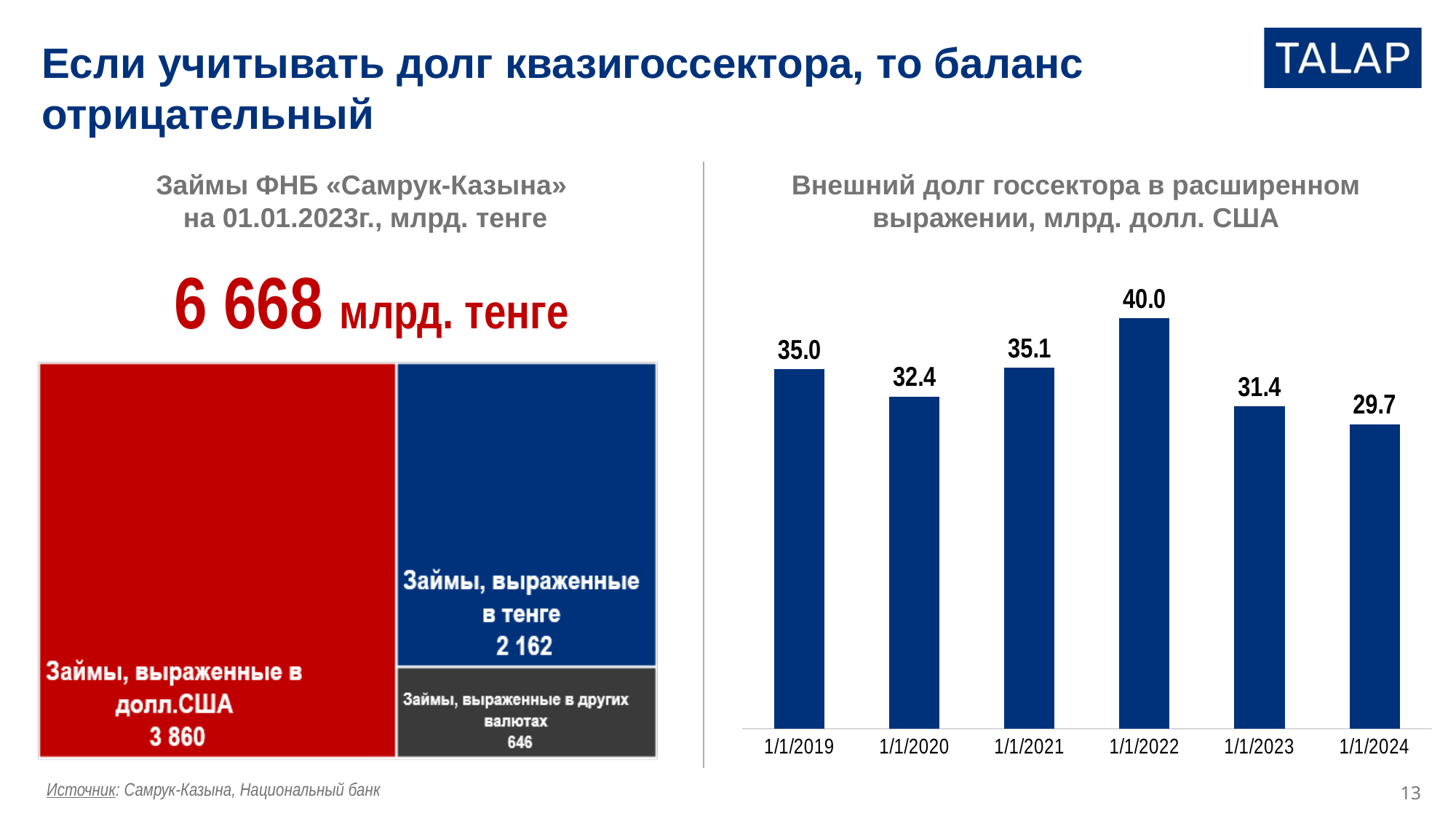
In the left chart (Займы ФНБ «Самрук-Казына»), what is the value for Займы, выраженные в долл.США? 3 860 In the right chart (Внешний долг госсектора в расширенном выражении), which is larger: the value for 1/1/2019 or for 1/1/2020? 1/1/2019 In the right chart (Внешний долг госсектора в расширенном выражении), what is the value for 1/1/2022? 40.0 In the right chart (Внешний долг госсектора в расширенном выражении), what is the difference between the values for 1/1/2022 and 1/1/2024? 10.3 What kind of chart is the right chart (Внешний долг госсектора в расширенном выражении)? bar chart In the left chart (Займы ФНБ «Самрук-Казына»), what is the difference between loans in US dollars and loans in tenge? 1 698 In the right chart (Внешний долг госсектора в расширенном выражении), how many bars are shown? 6 In the left chart (Займы ФНБ «Самрук-Казына»), what is the total of all loans shown? 6 668 млрд. тенге In the right chart (Внешний долг госсектора в расширенном выражении), what is the value for 1/1/2024? 29.7 In the right chart (Внешний долг госсектора в расширенном выражении), which date has the lowest value? 1/1/2024 In the left chart (Займы ФНБ «Самрук-Казына»), what is the value for Займы, выраженные в других валютах? 646 In the right chart (Внешний долг госсектора в расширенном выражении), which date has the highest value? 1/1/2022